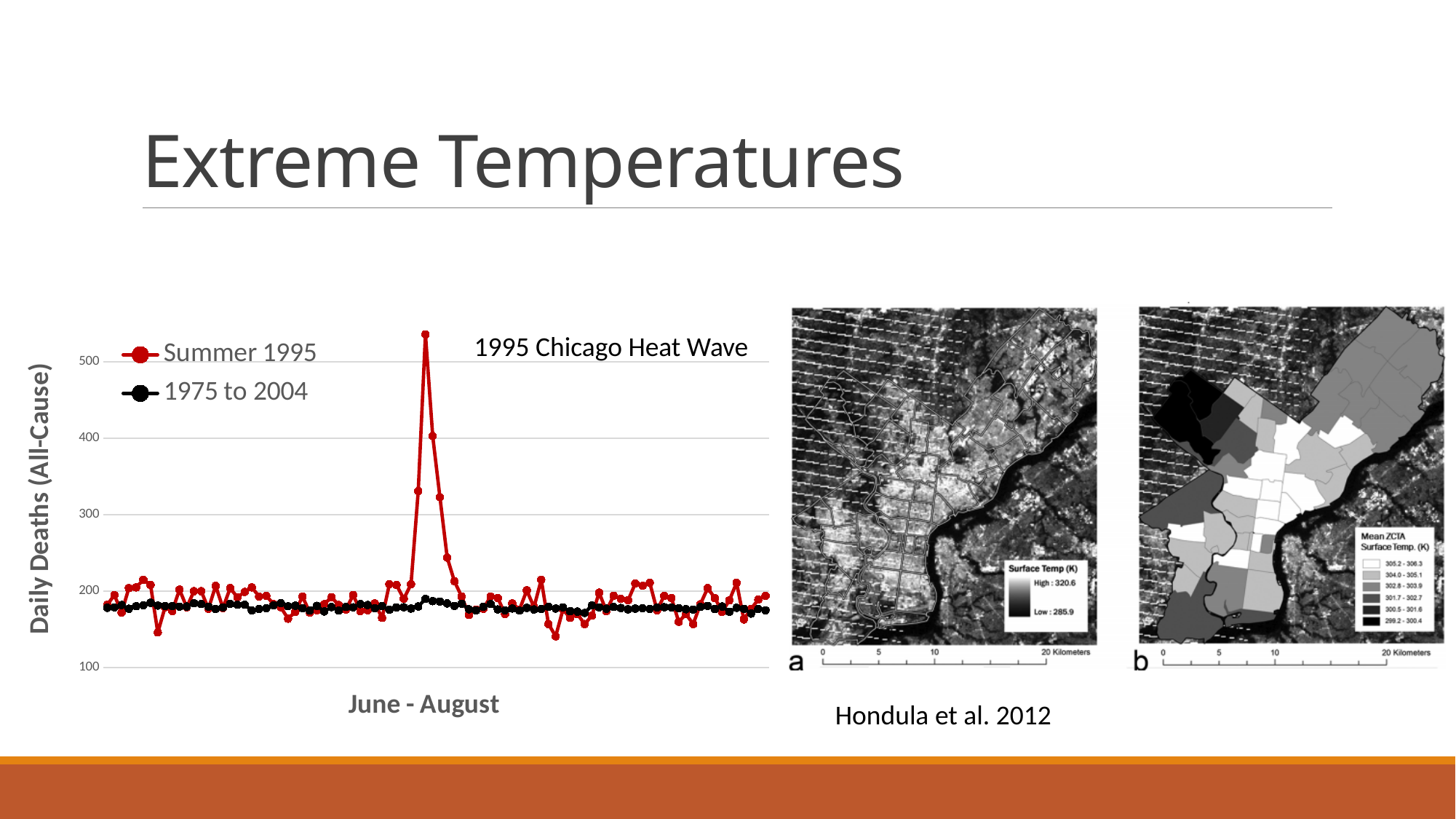
In the line chart, is the lowest value of the Summer 1995 series greater or less than 100? greater In the line chart, is the peak value of the Summer 1995 series greater or less than 500? greater How many series does the legend of the line chart list? 2 In the line chart, is the peak value of the 1975 to 2004 series greater or less than 300? less What kind of chart is shown on the left of the slide? line chart In the line chart, which series reaches the higher peak, Summer 1995 or 1975 to 2004? Summer 1995 Which series in the line chart is drawn in red? Summer 1995 What is the y-axis title of the line chart? Daily Deaths (All-Cause)